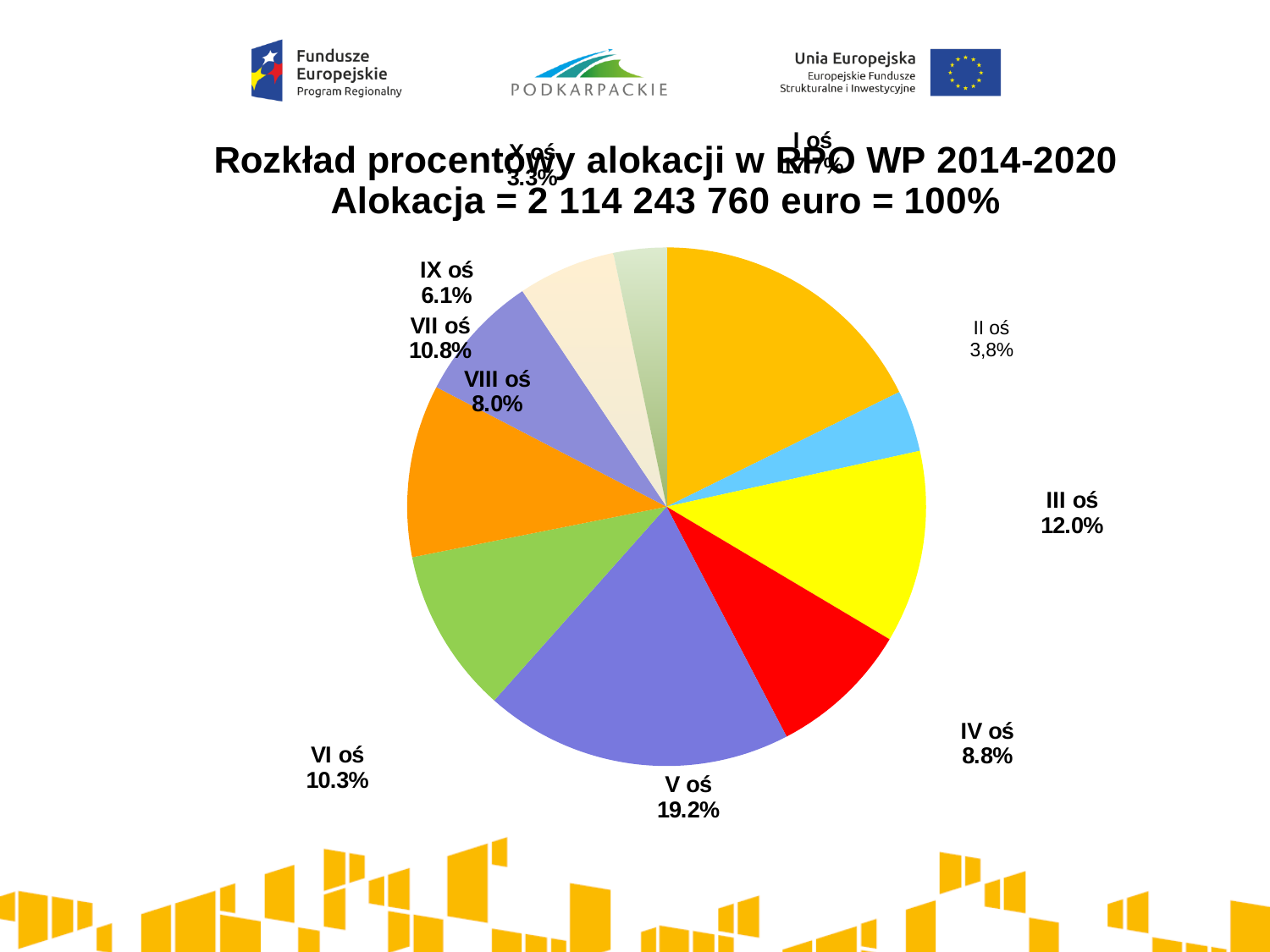
Which has a larger share, V oś or VI oś? V oś What percentage is labelled for VII oś? 10.8% What is the value shown for IX oś? 6.1% How many slices does the pie chart have? 10 What is the value shown for VIII oś? 8.0% Which has a larger share, III oś or IV oś? III oś What is the difference in percentage points between III oś (12.0%) and IV oś (8.8%)? 3.2 What is the value shown for III oś? 12.0% What kind of chart is shown on the slide? pie chart What is the value shown for II oś? 3,8% What total allocation in euro is stated in the chart title as equal to 100%? 2 114 243 760 euro What percentage share does V oś have in the pie chart? 19.2%